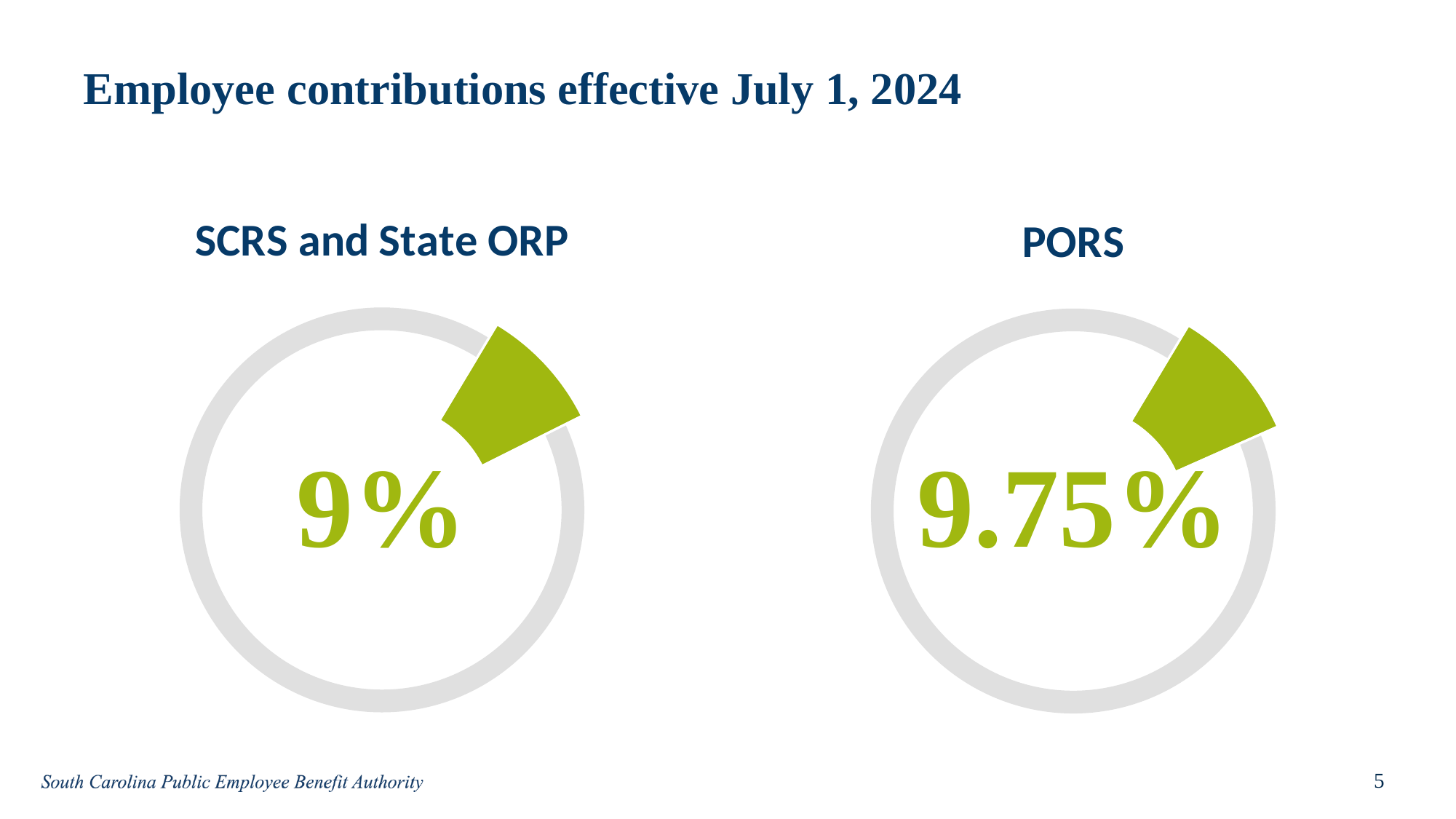
What is the difference between the PORS rate and the SCRS and State ORP rate? 0.75% How many charts are shown on the slide? 2 What kind of chart is used on the SCRS and State ORP side of the slide? Doughnut chart What colour is the highlighted segment on the PORS chart? Green Is the value on the PORS chart greater or less than 9%? greater What is the title of the slide? Employee contributions effective July 1, 2024 On the PORS chart, what employee contribution rate is shown? 9.75% Which chart shows the higher contribution rate, SCRS and State ORP or PORS? PORS On the SCRS and State ORP chart, what employee contribution rate is shown? 9%